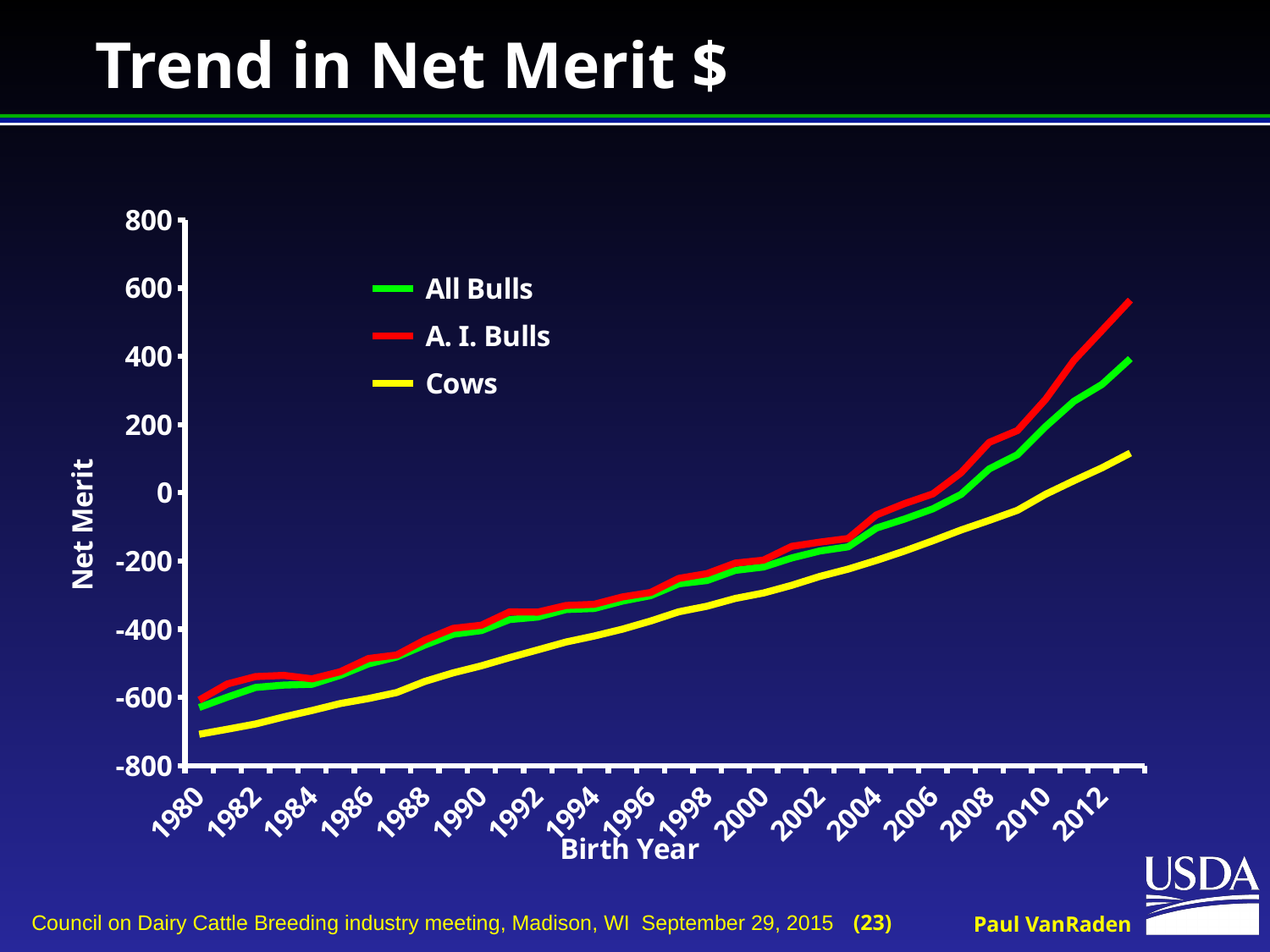
How many birth years are labeled on the x axis? 17 What is the title of the chart? Trend in Net Merit $ What kind of chart is shown on the slide? line chart Which series has the lowest Net Merit across the birth years shown? Cows At birth year 2012, which is larger: the Net Merit for A. I. Bulls or for Cows? A. I. Bulls Is the Net Merit for Cows at birth year 2006 greater or less than 0? less Do the Net Merit values for A. I. Bulls rise or fall as birth year increases? rise Is the Net Merit for A. I. Bulls at birth year 2012 greater or less than 400? greater Which series has the highest Net Merit at birth year 2012? A. I. Bulls Is the Net Merit for Cows at birth year 1980 greater or less than -600? less What is the label of the x axis? Birth Year How many series does the legend list? 3